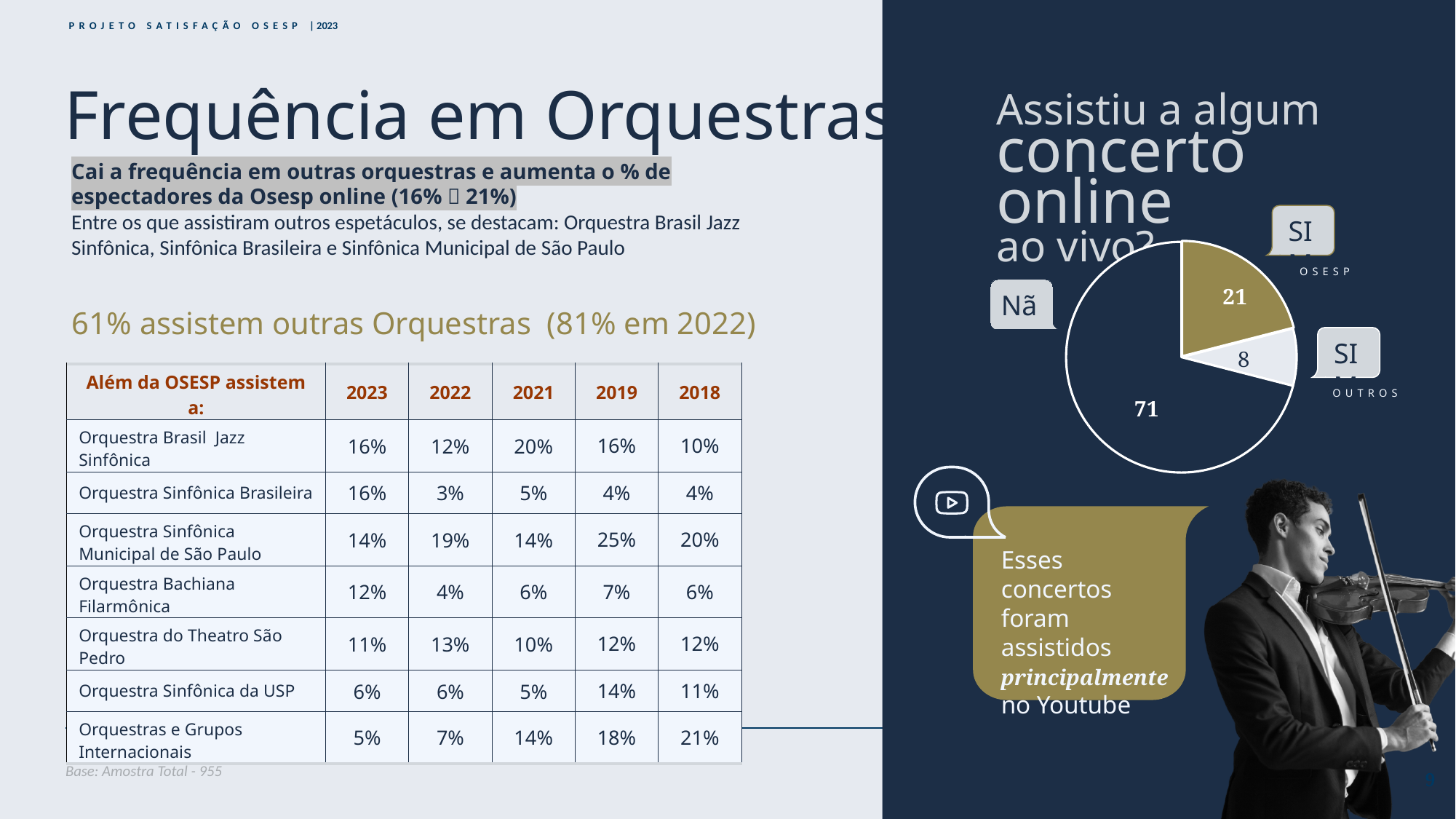
In the pie chart, which is larger: the 'OSESP' slice or the 'OUTROS' slice? OSESP How many slices does the pie chart have? 3 In the pie chart, what value is shown for the largest slice? 71 What kind of chart is shown on the right side of the slide under 'Assistiu a algum concerto online ao vivo?'? pie chart What is the total of the three values shown in the pie chart? 100 Which slice of the pie chart is the smallest? OUTROS (8) What question is the pie chart answering, according to the heading above it? Assistiu a algum concerto online ao vivo? In the pie chart, what value is shown for the 'OSESP' slice? 21 What colour is the slice labelled 21 in the pie chart? gold In the pie chart, what value is shown for the 'OUTROS' slice? 8 What share of the pie does the slice labelled 71 represent? 71% In the pie chart, what is the difference between the 'OSESP' slice and the 'OUTROS' slice? 13